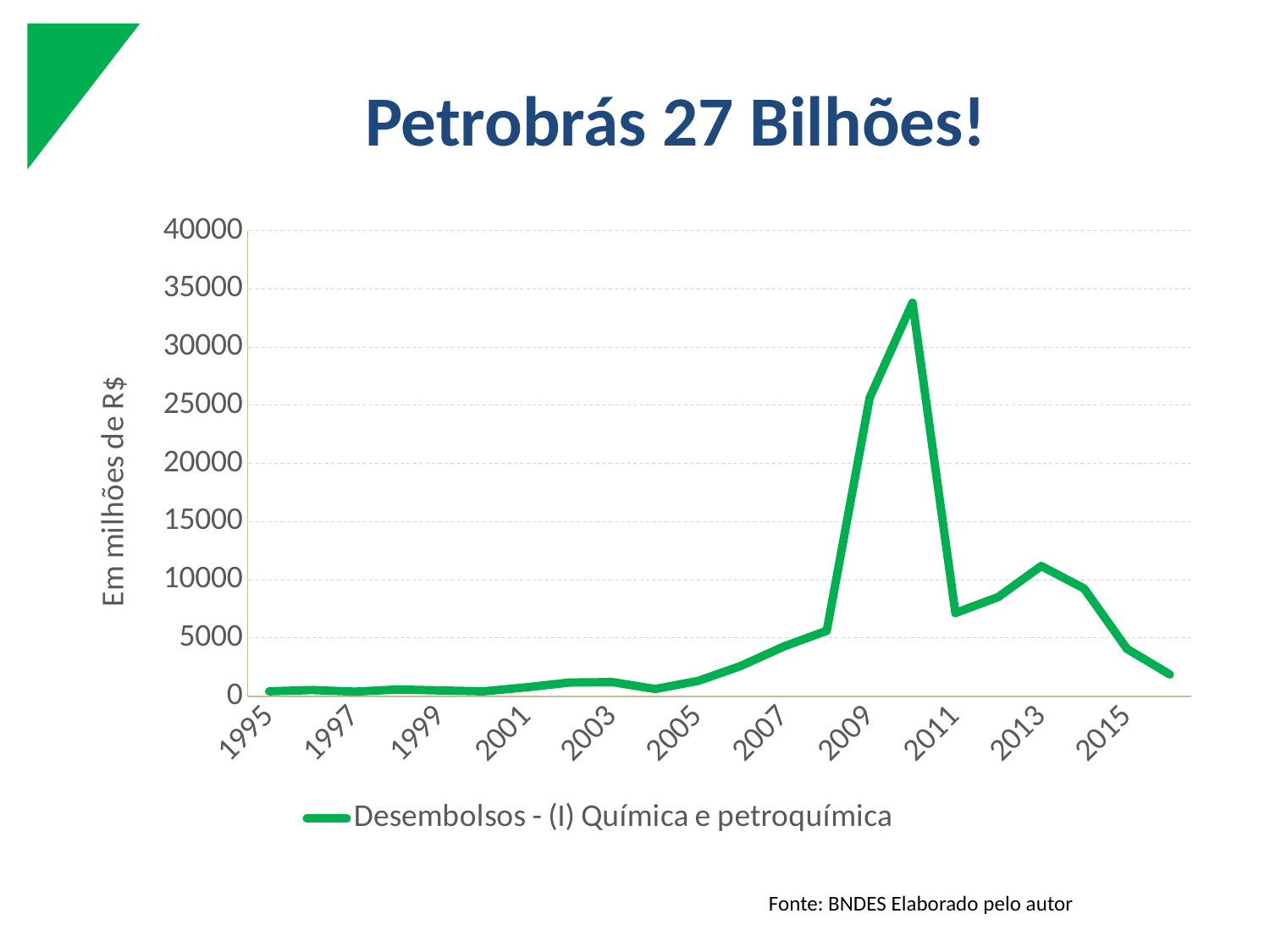
In which year does the line reach its highest value? 2010 Is the value for 2010 greater or less than 30000? greater Is the value for 2015 greater or less than 5000? less Is the value for 2009 greater or less than 20000? greater Does the line rise or fall between 2010 and 2011? fall What kind of chart is shown on the slide? line chart What is the label on the vertical axis? Em milhões de R$ What is the legend entry for the plotted series? Desembolsos - (I) Química e petroquímica How many series does the legend list? 1 Which year has the larger value, 2009 or 2013? 2009